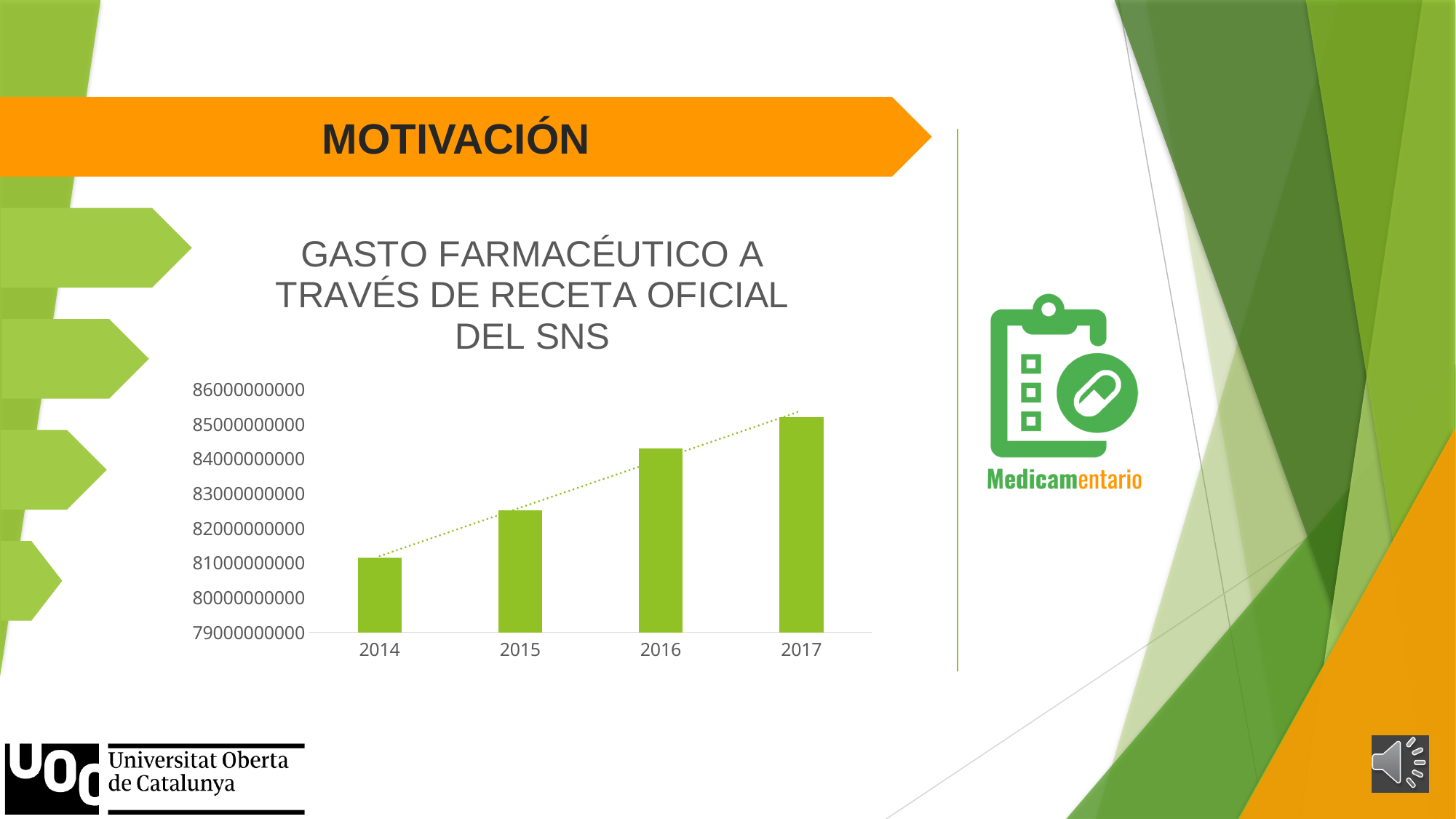
Which year has the highest value in the chart? 2017 Is the value for 2017 greater or less than 85000000000? greater How many years are shown on the x axis of the chart? 4 Do the values rise or fall from 2014 to 2017? rise What kind of chart is shown on the slide? bar chart Which year has the lowest value in the chart? 2014 Is the value for 2016 greater or less than 84000000000? greater Is the value for 2015 greater or less than 83000000000? less Which is larger, the value for 2015 or the value for 2016? 2016 What is the lowest value shown on the y axis of the chart? 79000000000 What is the title of the chart? GASTO FARMACÉUTICO A TRAVÉS DE RECETA OFICIAL DEL SNS